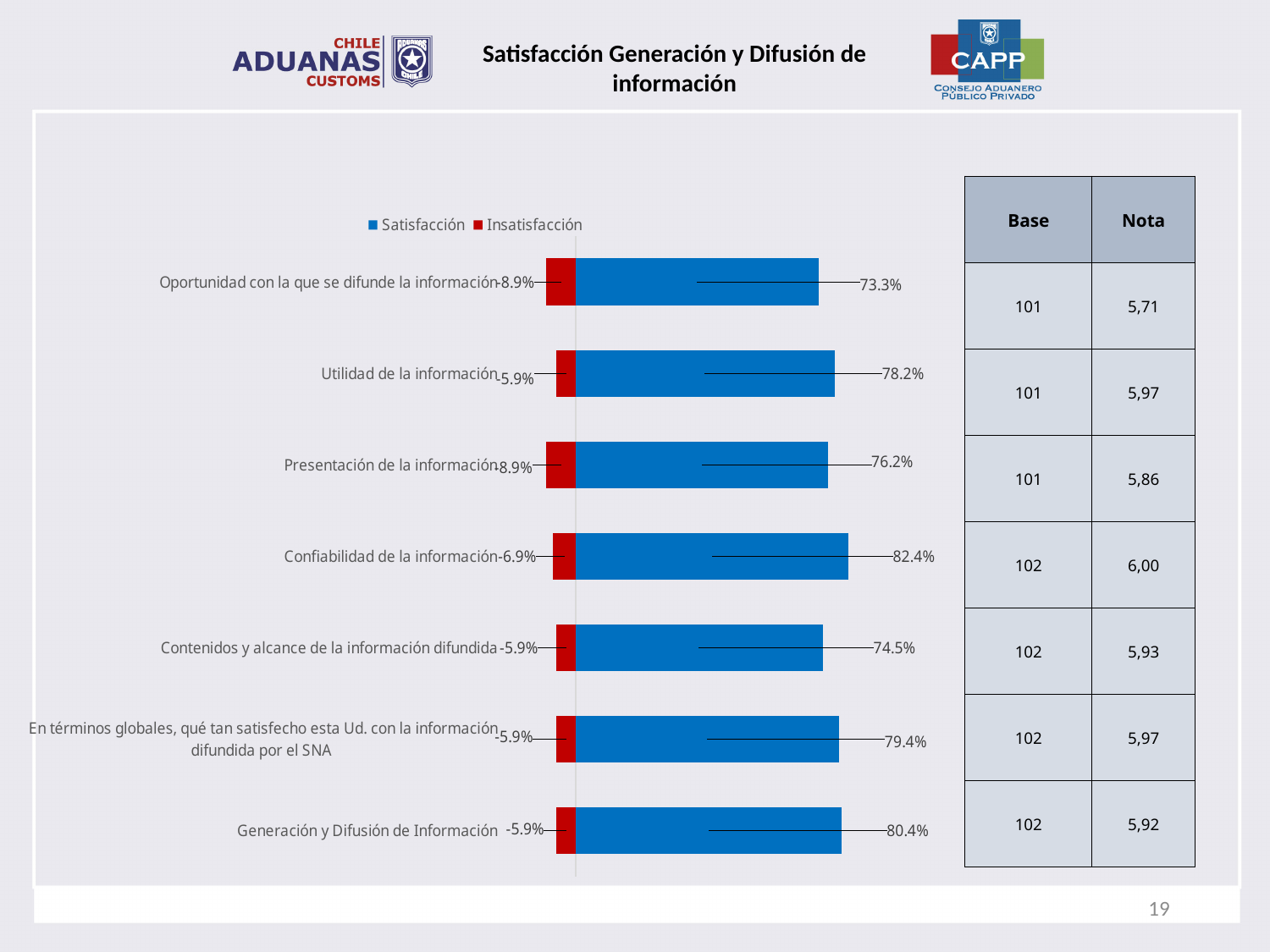
What kind of chart is shown on the slide? Bar chart What is the difference between the Satisfacción values for Confiabilidad de la información and Oportunidad con la que se difunde la información? 9.1% What is the Satisfacción value for Generación y Difusión de Información? 80.4% What is the Insatisfacción value for Oportunidad con la que se difunde la información? -8.9% What is the Satisfacción value for Confiabilidad de la información? 82.4% How many categories are shown in the chart? 7 How many series does the legend list? 2 What is the Insatisfacción value for Utilidad de la información? -5.9% Which has a larger Satisfacción value, Utilidad de la información or Presentación de la información? Utilidad de la información Which colour represents the Insatisfacción series in the chart? Red Which category has the lowest Satisfacción value? Oportunidad con la que se difunde la información Which category has the highest Satisfacción value? Confiabilidad de la información